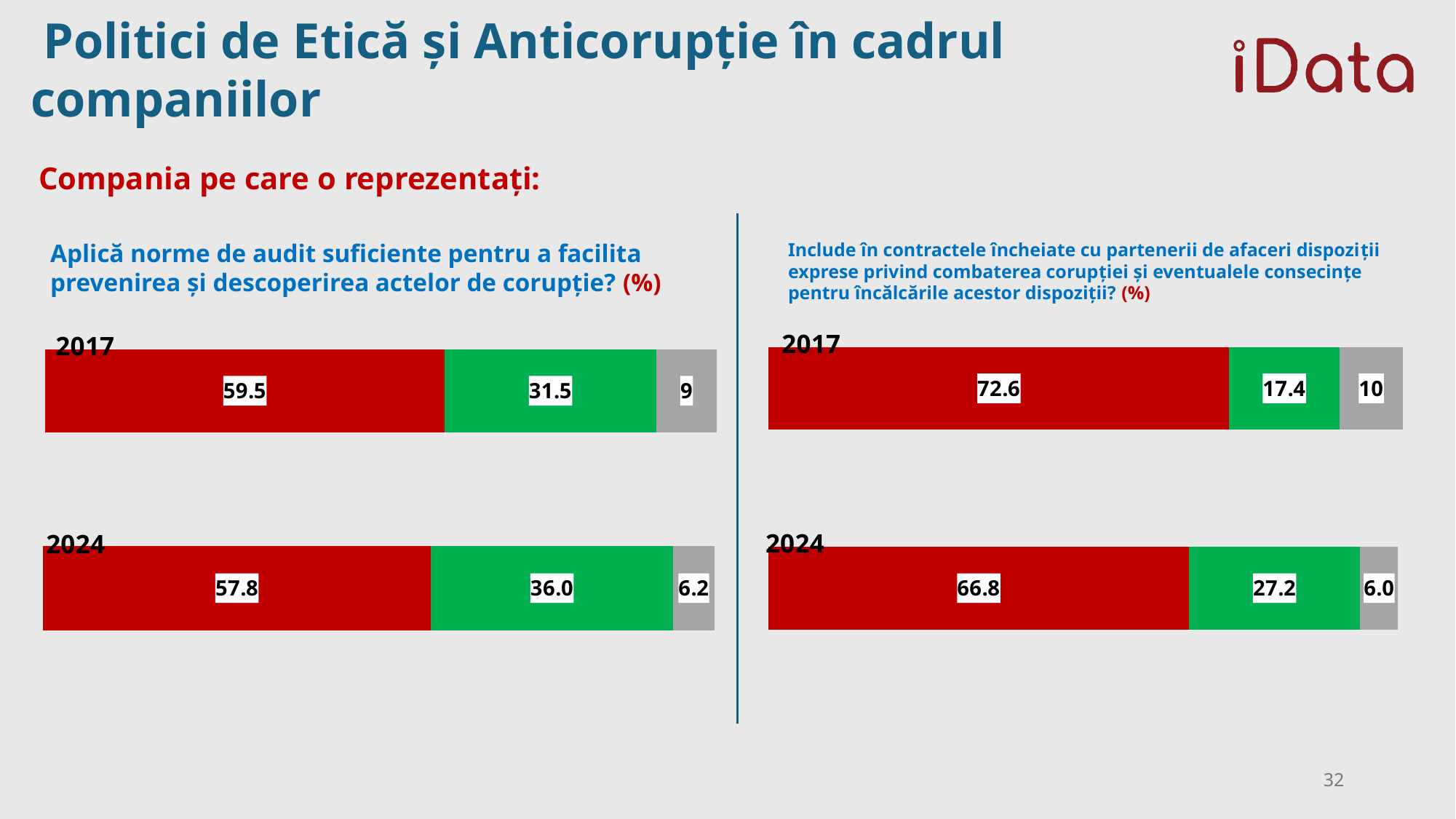
In the left chart, did the red segment rise or fall from 2017 to 2024? fall In the left chart ("Aplică norme de audit suficiente..."), what is the value of the green segment for 2024? 36.0 In the left chart ("Aplică norme de audit suficiente..."), what is the value of the red segment for 2017? 59.5 In the right chart ("Include în contractele încheiate cu partenerii de afaceri..."), what is the value of the grey segment for 2024? 6.0 In the right chart, which year has the larger green segment, 2017 or 2024? 2024 In the right chart, what is the difference between the red segment values for 2017 and 2024? 5.8 In the right chart, what is the value of the green segment for 2024? 27.2 In the left chart, by how much did the green segment change from 2017 to 2024? 4.5 In the left chart, what is the value of the grey segment for 2017? 9 In the right chart ("Include în contractele încheiate cu partenerii de afaceri..."), what is the value of the red segment for 2017? 72.6 How many years (bars) are shown in the right chart? 2 What type of chart is used on the left side of the slide? stacked bar chart